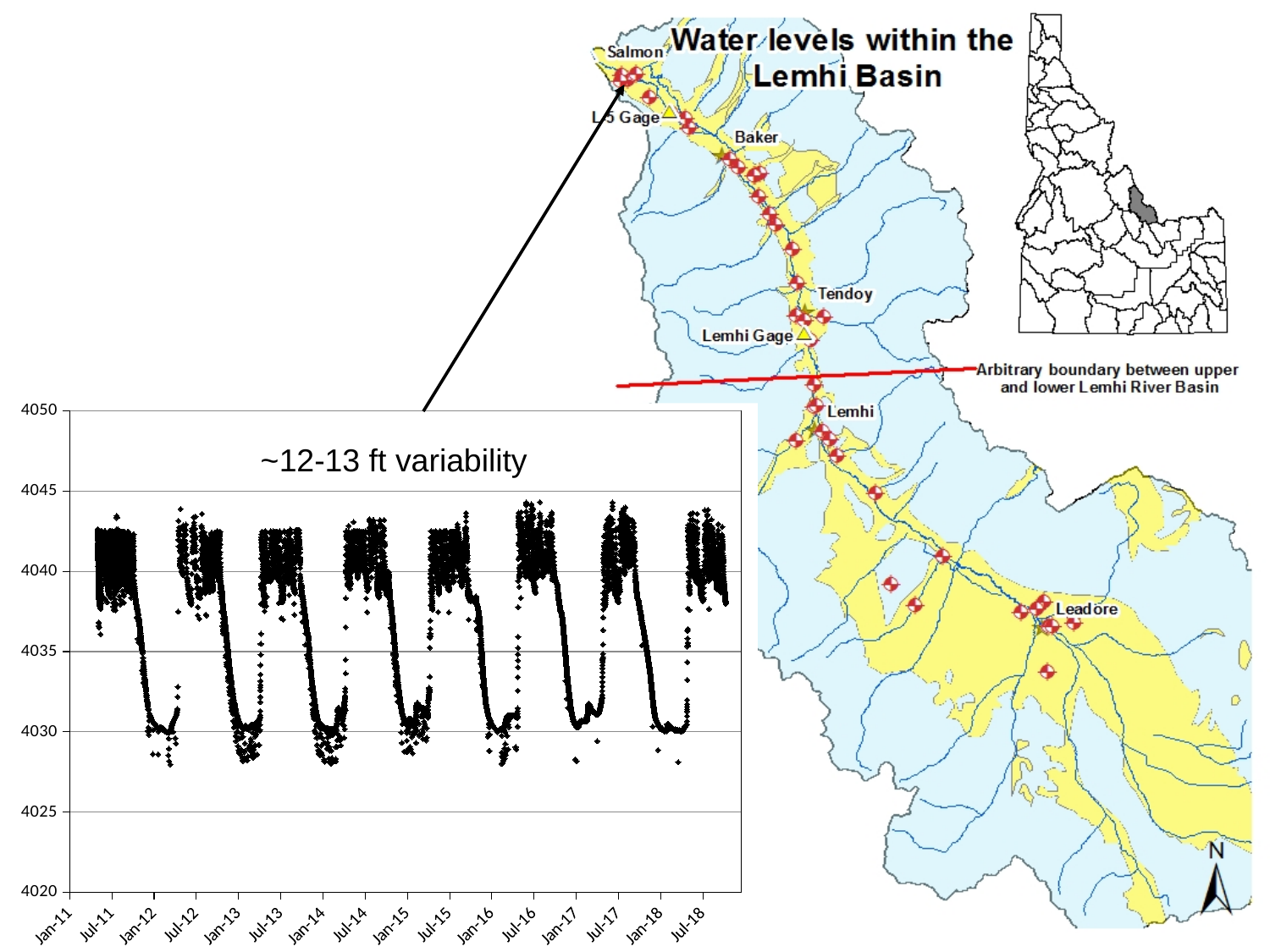
Is the highest plotted value on the chart greater or less than 4045? less What kind of chart is shown on the left of the slide? scatter chart How many tick labels are shown on the x axis of the chart? 16 What variability does the annotation on the chart state? ~12-13 ft variability What is the lowest value shown on the y axis of the chart? 4020 Do the plotted values rise or fall between Jul-11 and Jan-12? fall What is the first label on the x axis of the chart? Jan-11 Are the plotted values around Jan-12 greater or less than 4035? less Are the plotted values around Jul-12 greater or less than 4035? greater What is the highest value shown on the y axis of the chart? 4050 What is the last label on the x axis of the chart? Jul-18